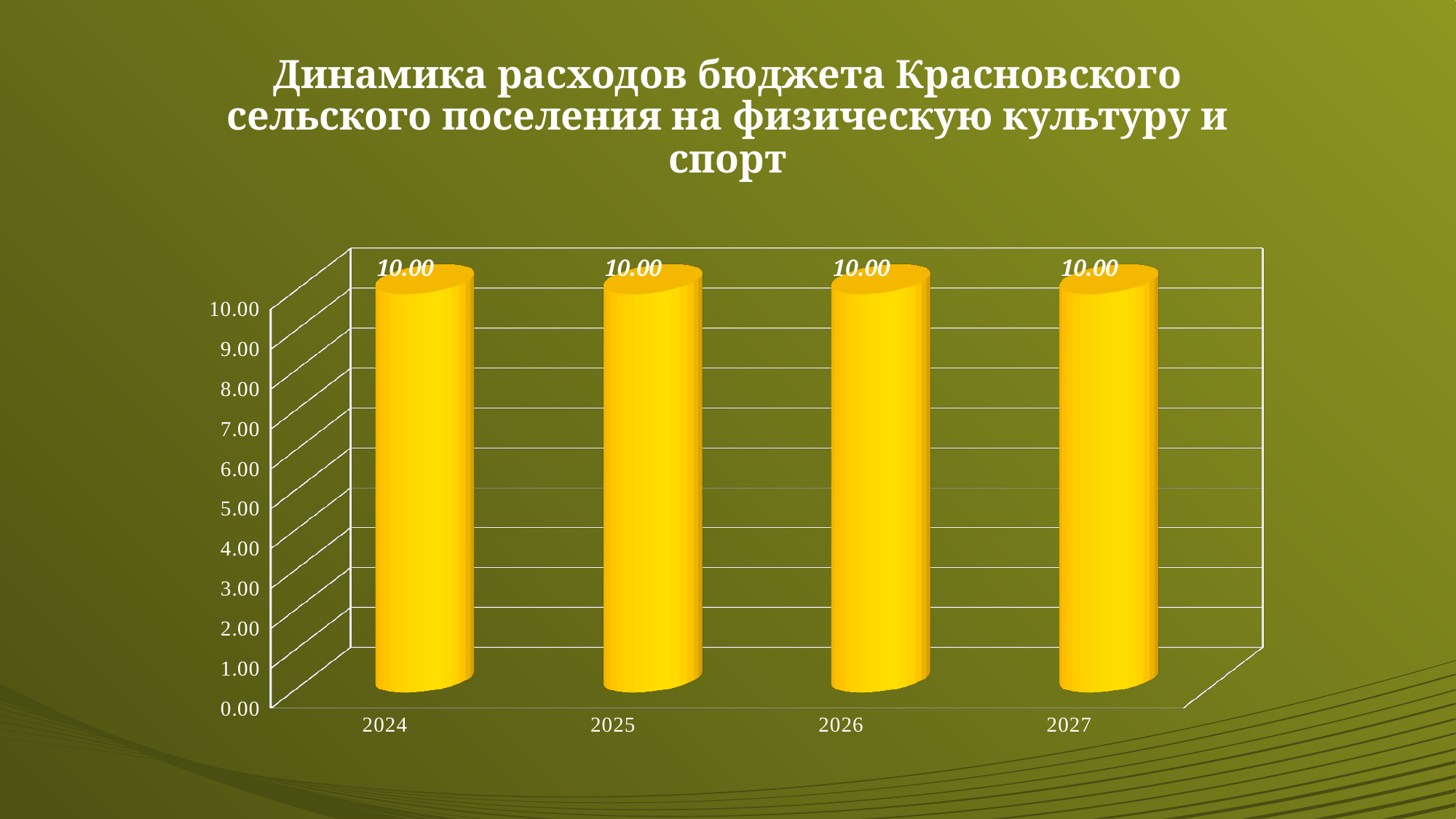
What is the difference between the values for 2027 and 2024? 0.00 Is the value for 2026 greater or less than 5.00? greater What is the value for 2024? 10.00 What is the title of the chart? Динамика расходов бюджета Красновского сельского поселения на физическую культуру и спорт What colour are the bars in the chart? yellow Are the values for 2025 and 2026 equal? yes What kind of chart is shown on the slide? bar chart What is the value for 2026? 10.00 What is the value for 2025? 10.00 What is the value for 2027? 10.00 Do the values rise, fall or stay the same from 2024 to 2027? stay the same How many years are shown on the x axis? 4